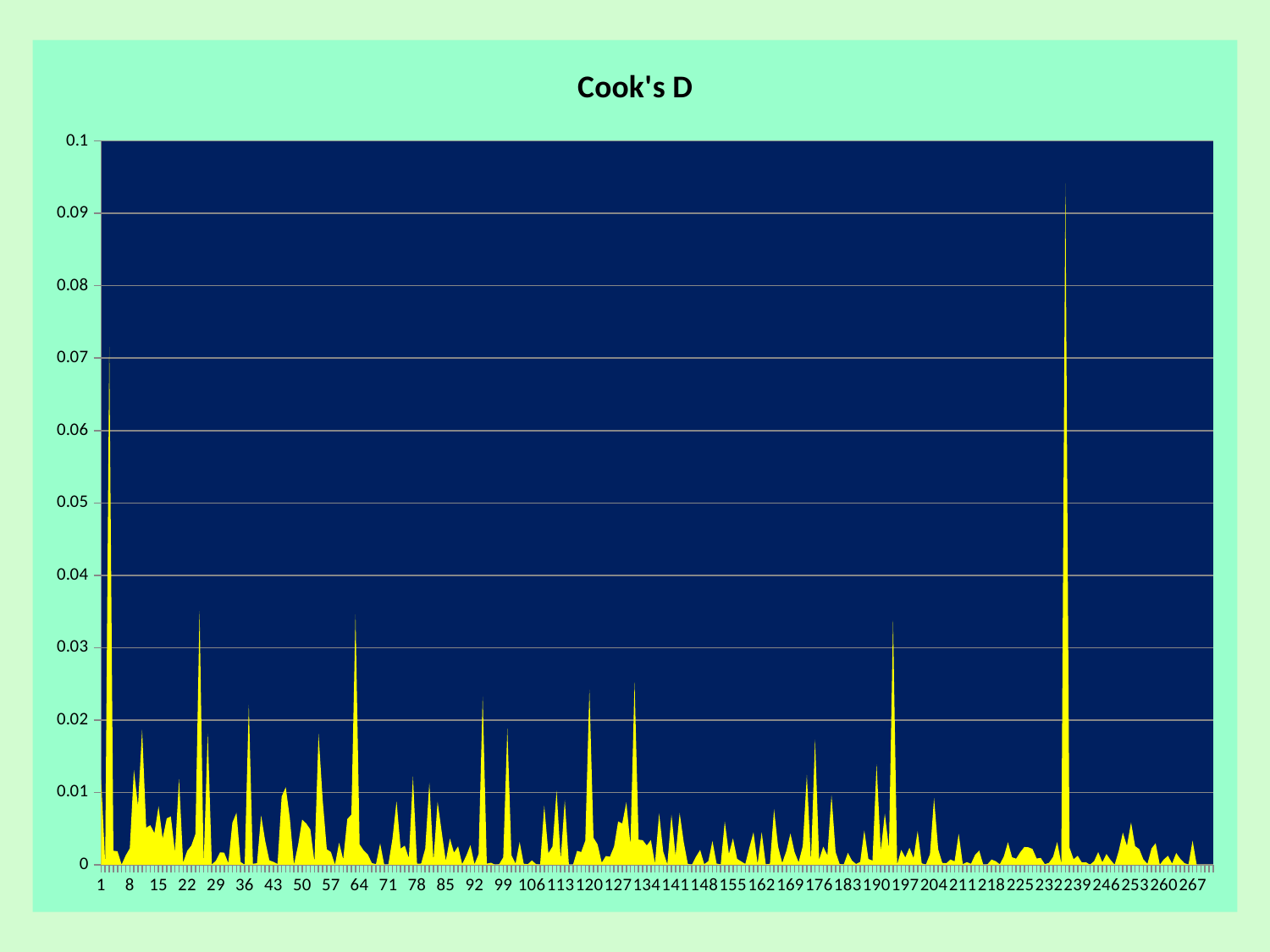
How many tick labels are shown on the y axis? 11 Which x-axis label is closest to the tallest spike in the chart? 239 What is the title of the chart? Cook's D What kind of chart is shown on the slide? area chart Which is larger: the spike near x-axis label 239 or the spike near x-axis label 1? the spike near 239 Is the spike near the left edge of the chart (near x-axis label 1) greater or less than 0.08? less What is the highest value shown on the y axis? 0.1 Is the spike near the left edge of the chart (near x-axis label 1) greater or less than 0.06? greater Is the tallest spike in the chart greater or less than 0.09? greater